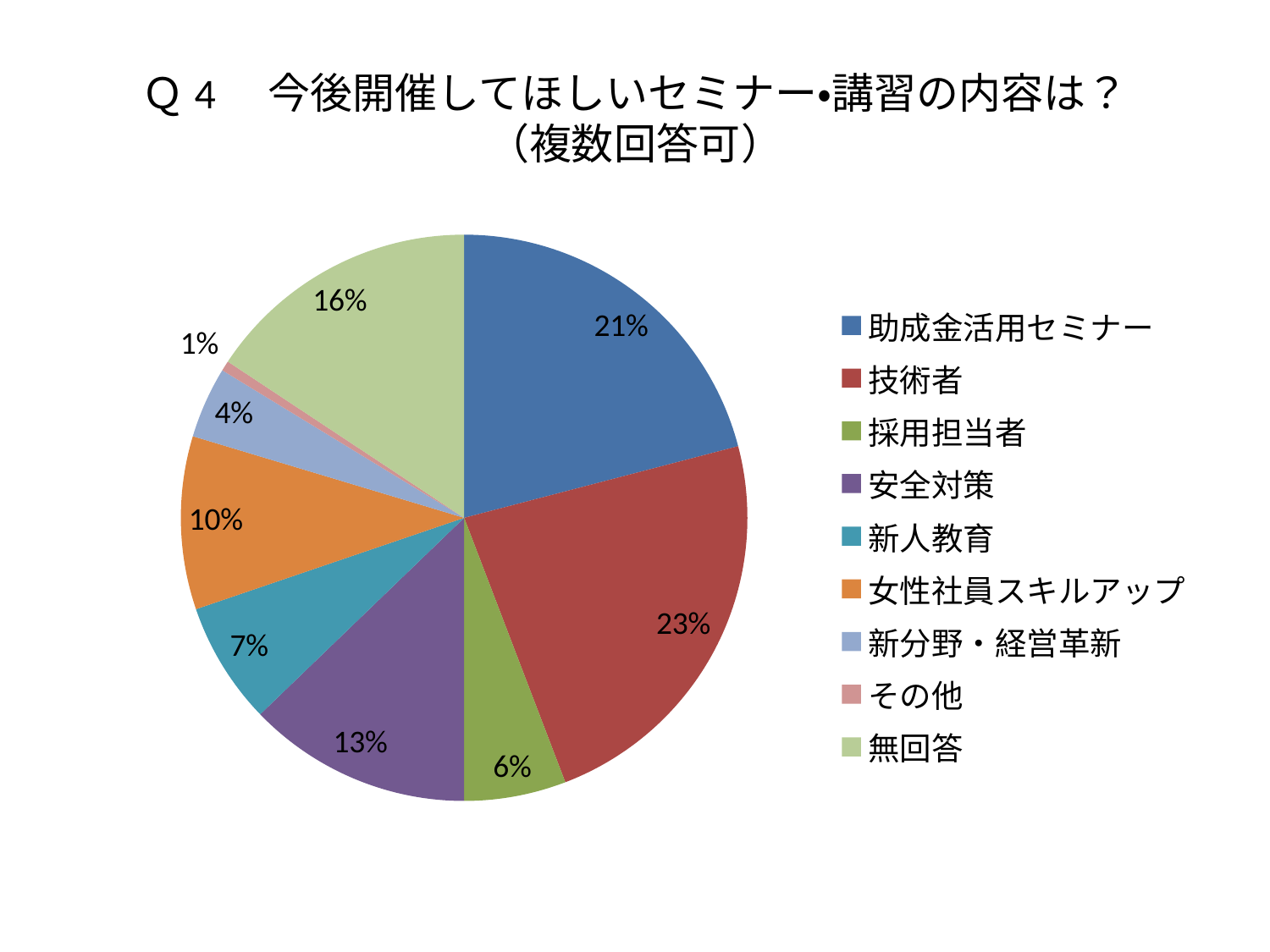
What kind of chart is shown on the slide? pie chart How many categories does the legend list? 9 What is the difference between the values for 技術者 and 助成金活用セミナー? 2% Which category has the smallest slice? その他 What is the value for 女性社員スキルアップ? 10% What is the value for 安全対策? 13% What share of the pie does 助成金活用セミナー have? 21% What is the value for 無回答? 16% What is the value for 技術者? 23% Which is larger, 新人教育 or 採用担当者? 新人教育 Which category has the largest slice? 技術者 What colour is the slice for 新分野・経営革新? light blue-purple